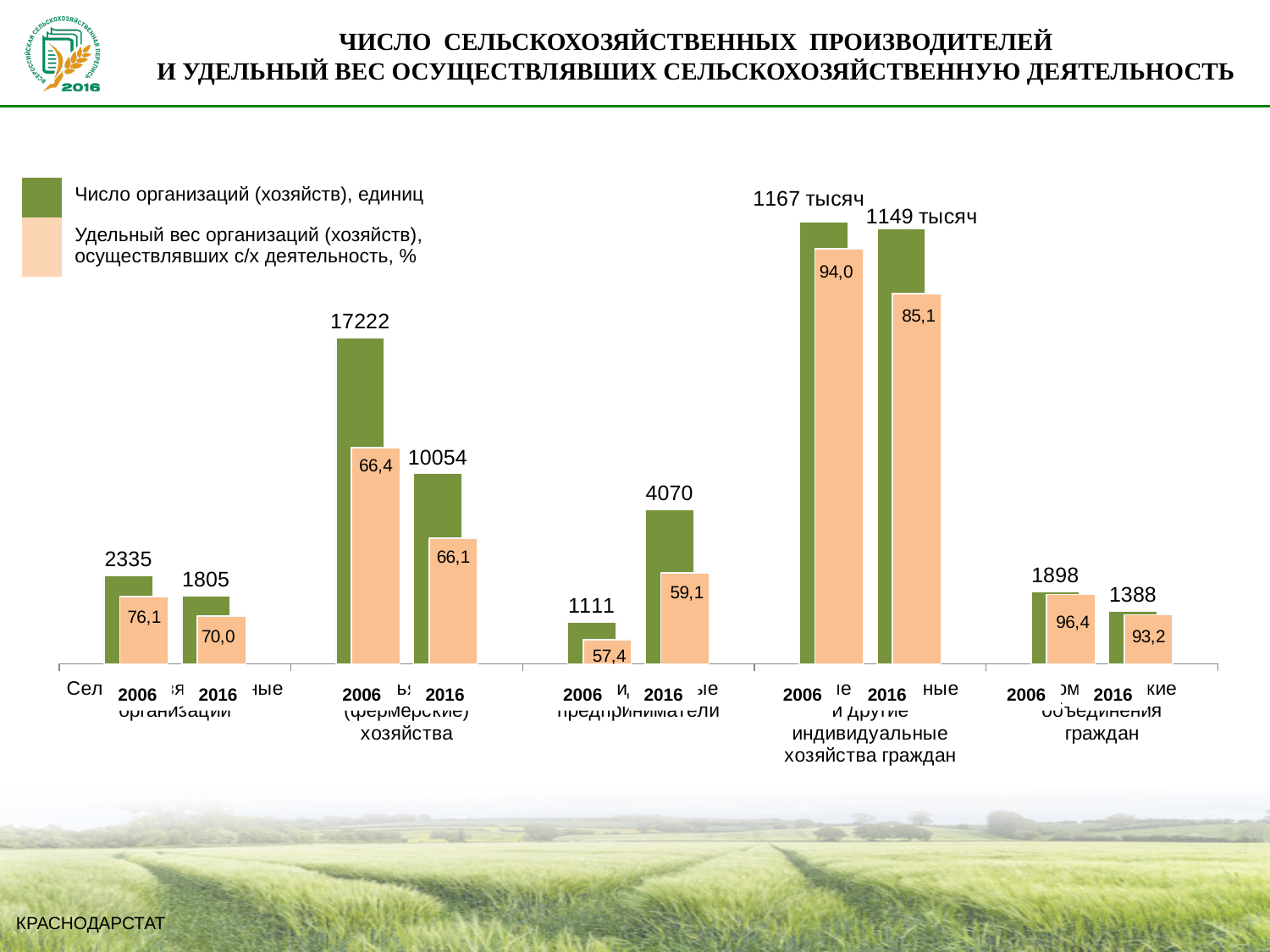
By how much did the number of сельскохозяйственные организации (first group) decrease from 2006 to 2016? 530 What is the share value for the fourth group (индивидуальные хозяйства граждан) in 2016? 85,1 For the third group (индивидуальные предприниматели), which year has the larger number of organisations, 2006 or 2016? 2016 What is the number of индивидуальные хозяйства граждан (fourth group) in 2006? 1167 тысяч What is the number of крестьянские (фермерские) хозяйства in 2016? 10054 What is the difference between the 2006 and 2016 share values for the fifth group (объединения граждан)? 3,2 Which share value (удельный вес) is the highest on the chart? 96,4 What is the удельный вес (share) of organisations carrying out agricultural activity for the first category group (сельскохозяйственные организации) in 2016? 70,0 Which share value (удельный вес) is the lowest on the chart? 57,4 What is the number of крестьянские (фермерские) хозяйства in 2006? 17222 How many series does the legend list? 2 What kind of chart is shown on the slide? bar chart